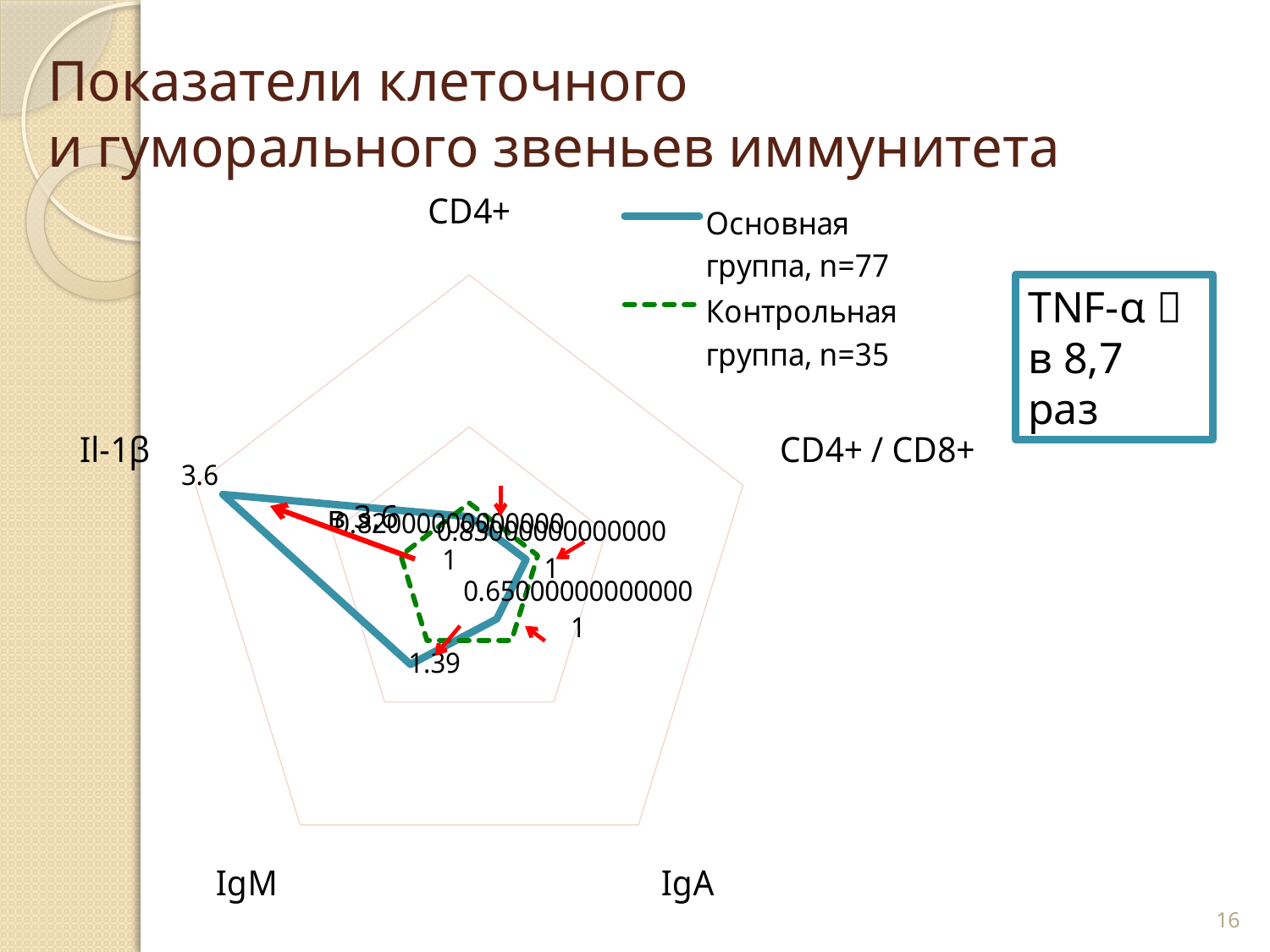
What type of chart is shown on the slide? Radar chart Which category has the highest value for the Основная группа series? Il-1β How many patients (n) are in the Основная группа according to the legend? 77 What is the value for Il-1β in the Основная группа series? 3.6 What line style is used for the Контрольная группа series? Dashed green line What is the value for IgM in the Основная группа series? 1.39 How many axes (categories) does the radar chart have? 5 What is the value for IgA in the Контрольная группа series? 1 For Il-1β, which series has the larger value: Основная группа or Контрольная группа? Основная группа What is the difference between the Основная группа values for Il-1β and IgM? 2.21 What is the value for IgA in the Основная группа series, as printed on the chart? 0.65000000000000 How many series does the chart legend list? 2